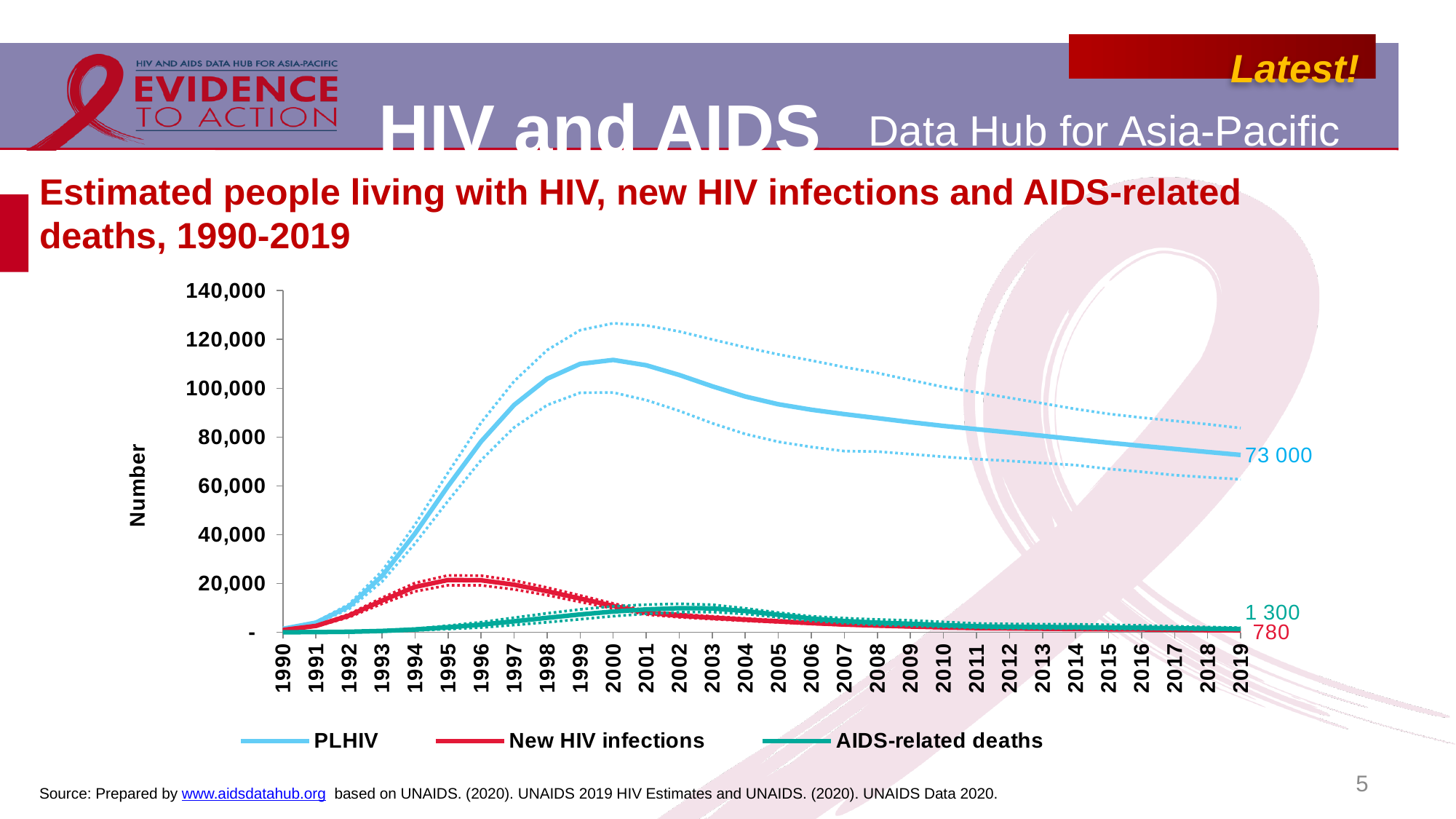
What is the value for PLHIV in 2019? 73 000 Which series has the highest value in 2019? PLHIV What is the value for New HIV infections in 2019? 780 What is the label on the vertical axis? Number In 2019, which is larger: AIDS-related deaths or New HIV infections? AIDS-related deaths What type of chart is shown on the slide? Line chart What is the difference between AIDS-related deaths and New HIV infections in 2019? 520 How many series does the legend list? 3 Is the value for PLHIV in 2000 greater or less than 100,000? greater Does the PLHIV line rise or fall from 2000 to 2019? Fall Is the value for New HIV infections in 1995 greater or less than 40,000? less What is the value for AIDS-related deaths in 2019? 1 300